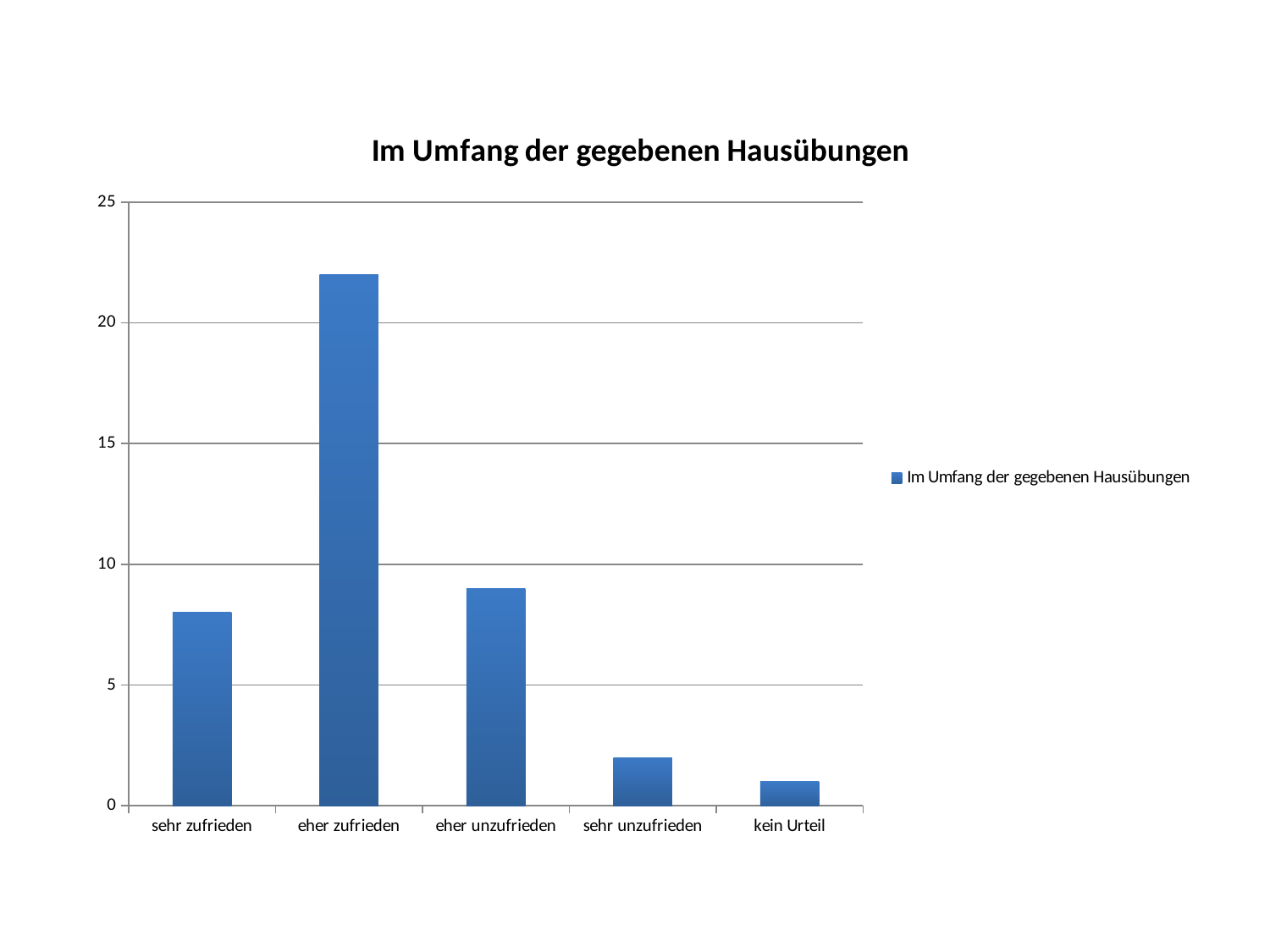
Which is larger, the value for eher zufrieden or the value for sehr zufrieden? eher zufrieden How many series does the legend list? 1 Which category has the lowest value? kein Urteil Is the value for eher zufrieden greater or less than 20? greater Is the value for eher unzufrieden greater or less than 10? less Which is larger, the value for eher unzufrieden or the value for sehr unzufrieden? eher unzufrieden What is the title of the chart? Im Umfang der gegebenen Hausübungen Is the value for sehr unzufrieden greater or less than 5? less What kind of chart is shown on the slide? bar chart How many categories are shown on the x axis? 5 Which category has the highest value? eher zufrieden